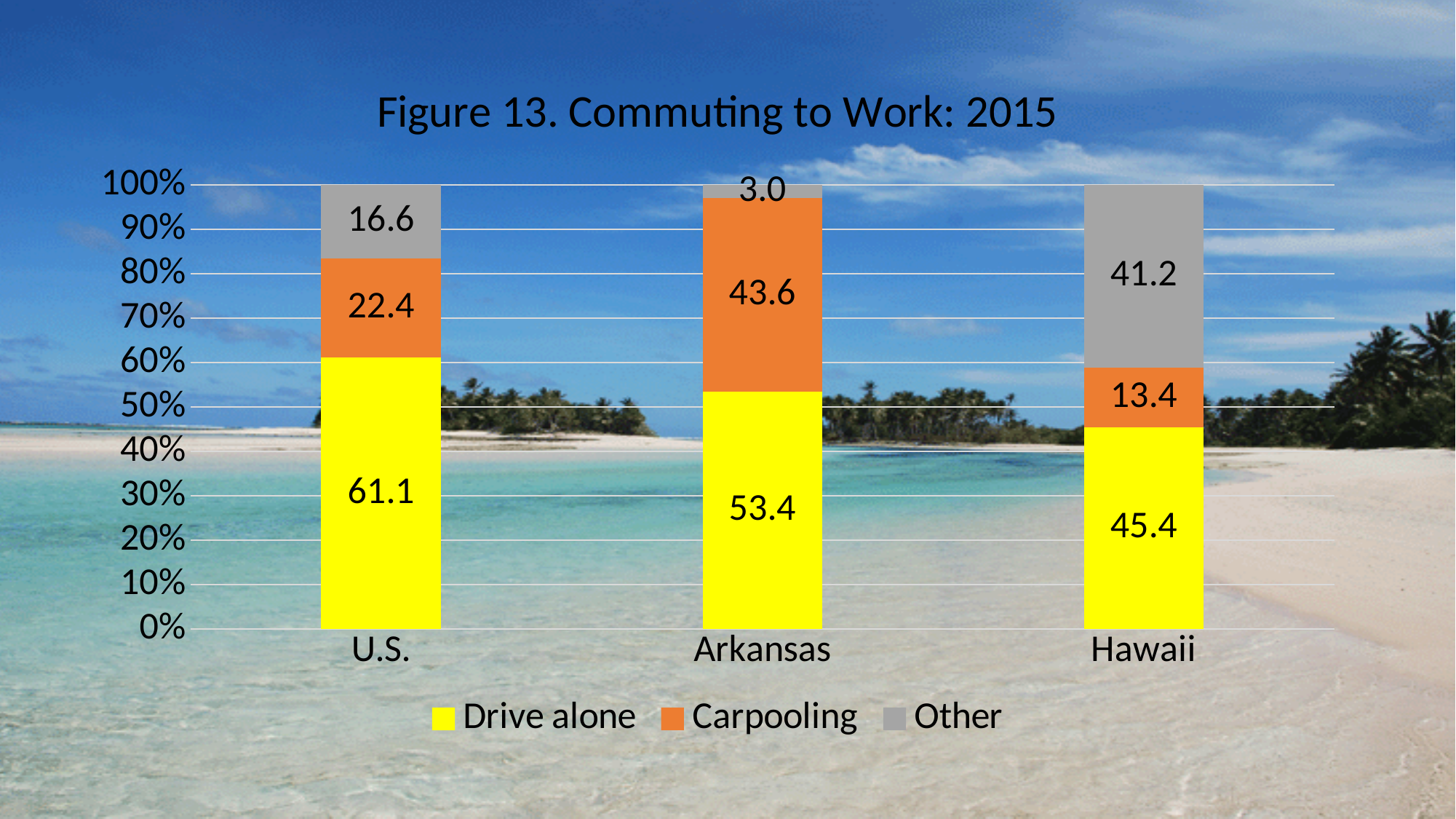
How many series does the legend list? 3 What kind of chart is shown on the slide? Stacked bar chart What is the Drive alone value for Hawaii? 45.4 Which is larger, the Other value for Hawaii or the Other value for the U.S.? Hawaii What is the Other value for the U.S.? 16.6 What is the title of the chart? Figure 13. Commuting to Work: 2015 Which category has the lowest Other value? Arkansas Do the Drive alone values rise or fall from U.S. to Hawaii along the x axis? Fall What is the difference between the Carpooling values for Arkansas and Hawaii? 30.2 Which category has the highest Drive alone value? U.S. How many categories are shown on the x axis? 3 What is the Carpooling value for Arkansas? 43.6